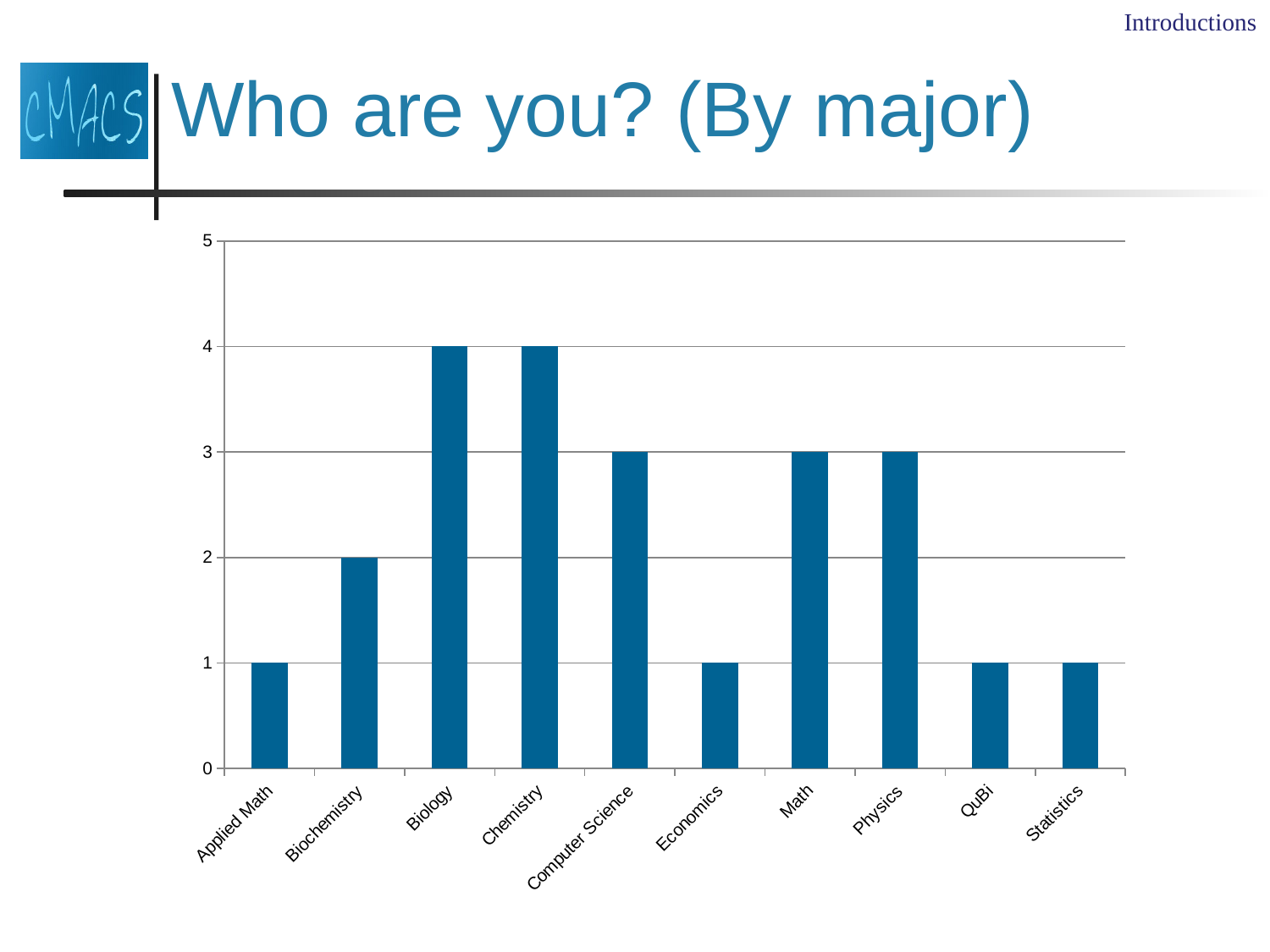
What is the value for Biochemistry? 2 What is the value for Biology? 4 How many majors (categories) are shown on the x axis? 10 Which two majors share the highest value? Biology and Chemistry What is the difference between the values for Biology and Biochemistry? 2 What is the title of the slide containing the chart? Who are you? (By major) Is the value for Chemistry greater or less than 3? greater What is the difference between the values for Math and Economics? 2 What is the value for Statistics? 1 What is the value for Computer Science? 3 What kind of chart is shown on the slide? bar chart Which is larger, the value for Computer Science or the value for Economics? Computer Science